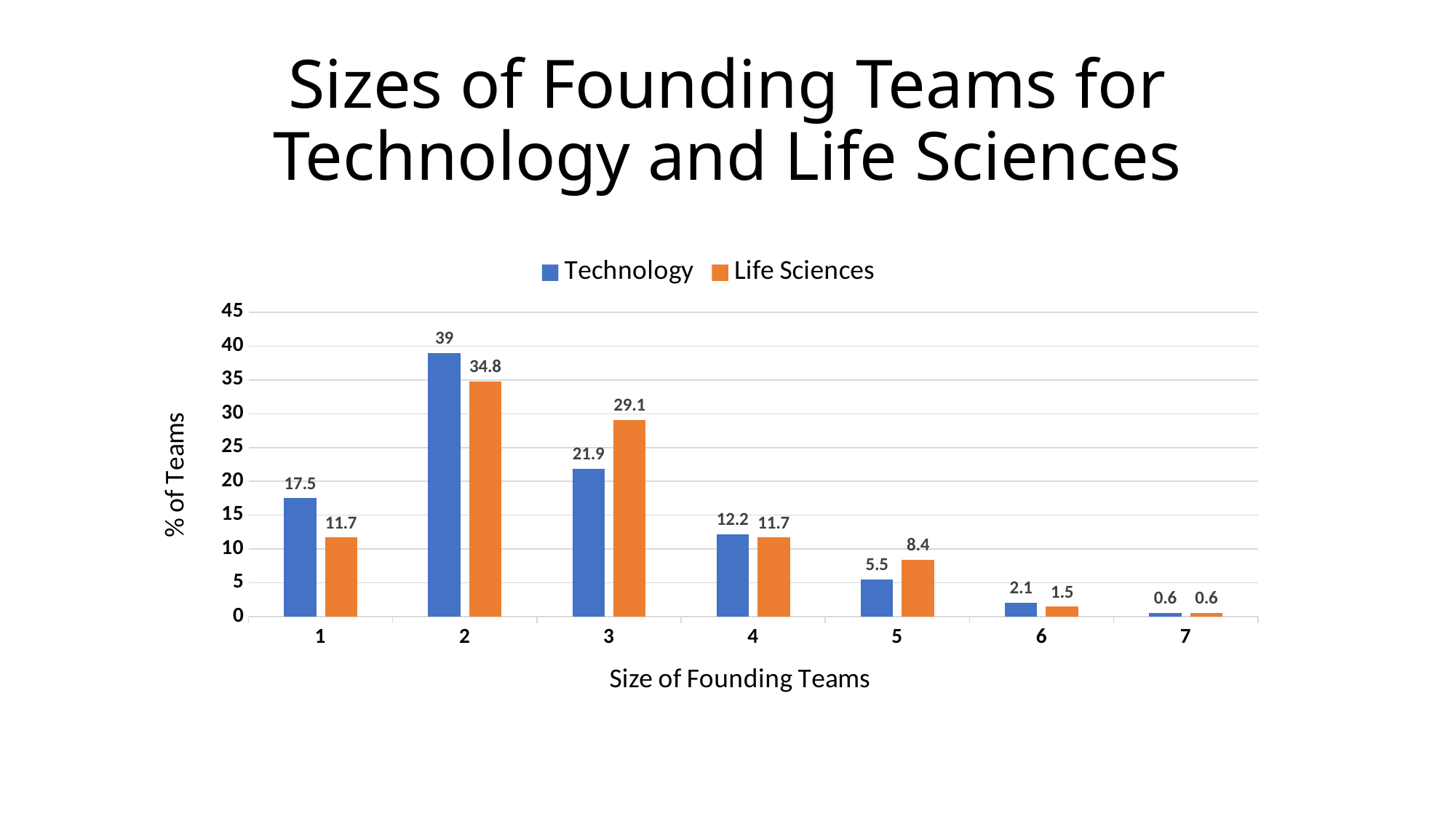
Do the Technology values rise or fall from founding team size 2 to size 7? Fall Which founding team size has the highest Life Sciences value? 2 What is the label of the y axis? % of Teams What is the Technology value for founding team size 5? 5.5 What is the Life Sciences value for founding team size 3? 29.1 How many series does the legend list? 2 Which founding team size has the lowest Technology value? 7 What kind of chart is shown on the slide? Bar chart For founding team size 3, which series has the larger value, Technology or Life Sciences? Life Sciences How many founding team size categories are shown on the x axis? 7 What is the difference between the Technology and Life Sciences values for founding team size 1? 5.8 What is the Technology value for founding team size 2? 39